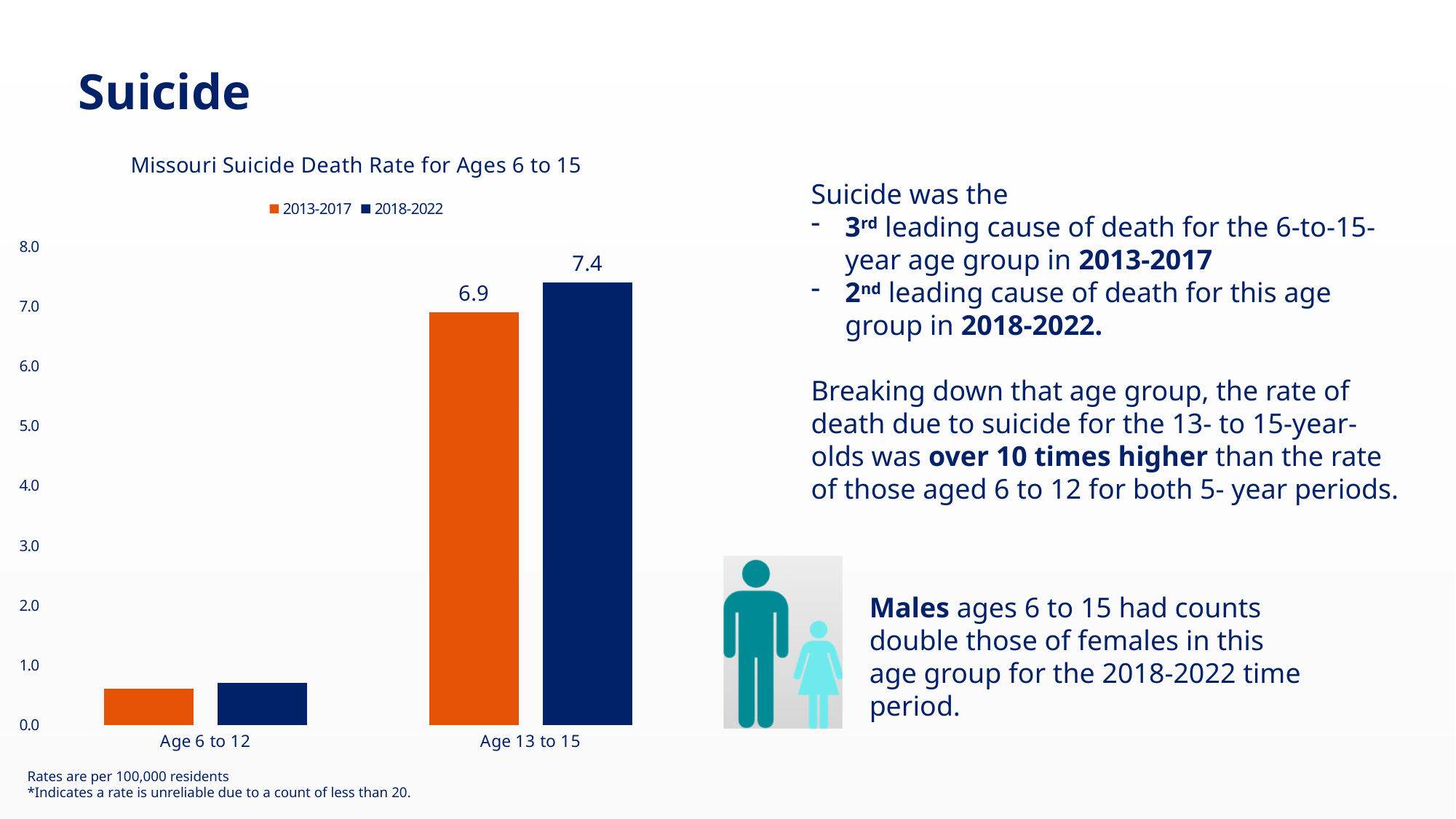
How many age groups are shown on the x axis of the chart? 2 For Age 13 to 15, which period has the larger rate, 2013-2017 or 2018-2022? 2018-2022 What is the difference between the 2018-2022 and 2013-2017 rates for Age 13 to 15? 0.5 How many series does the chart legend list? 2 What is the suicide death rate for Age 13 to 15 in 2018-2022? 7.4 Is the value for Age 6 to 12 in 2018-2022 greater or less than 1.0? less Which age group has the highest suicide death rate in 2018-2022? Age 13 to 15 Is the value for Age 6 to 12 in 2013-2017 greater or less than 1.0? less What kind of chart is shown on the slide? Bar chart What is the suicide death rate for Age 13 to 15 in 2013-2017? 6.9 Which age group has the lowest suicide death rate in 2013-2017? Age 6 to 12 What is the title of the chart? Missouri Suicide Death Rate for Ages 6 to 15